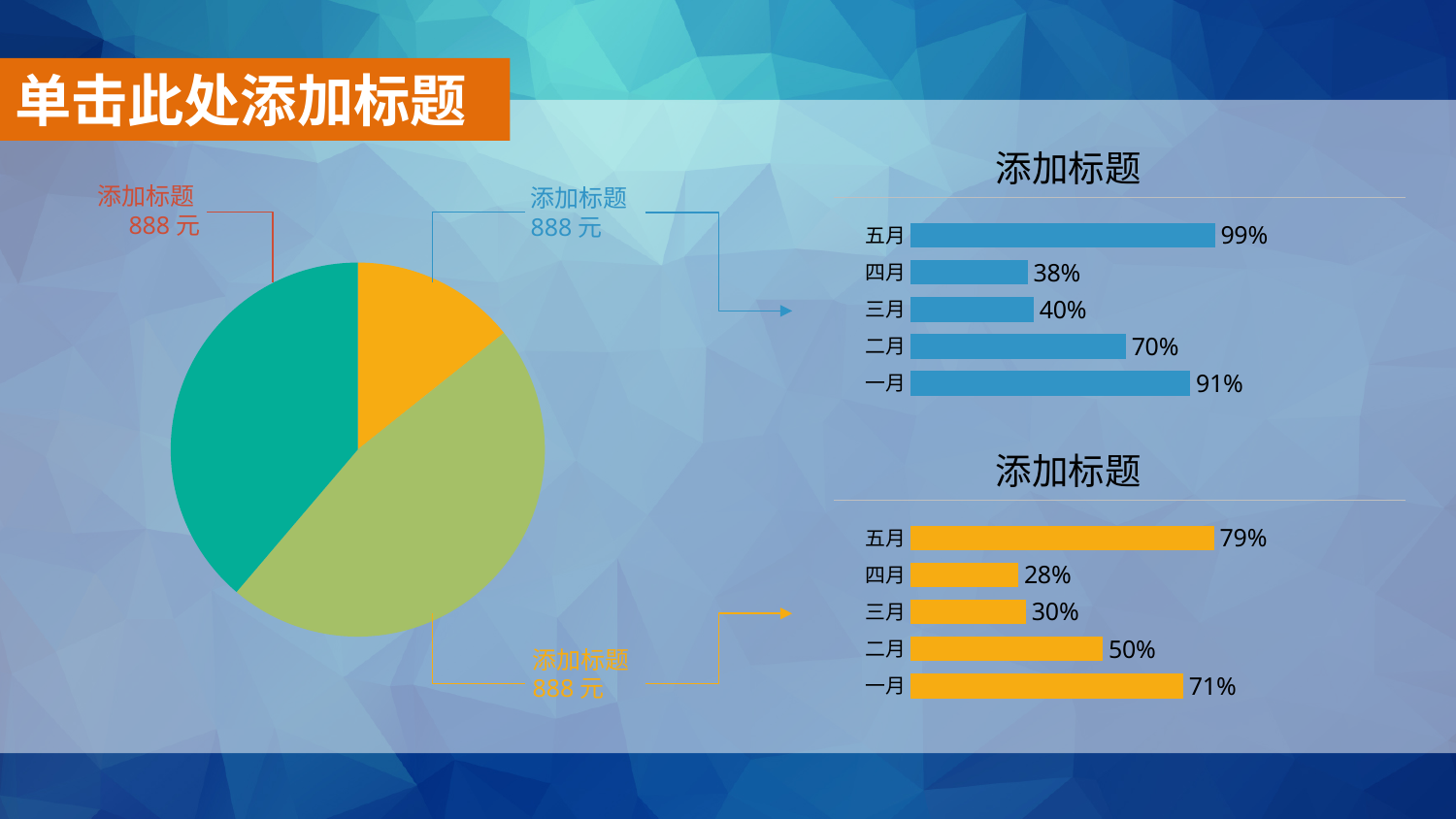
In the upper-right bar chart, what is the difference between the values for 五月 and 一月? 8% In the lower-right bar chart, which month has the highest value? 五月 What kind of chart is shown on the left side of the slide? Pie chart In the lower-right bar chart, what is the value for 三月? 30% How many months are shown in the upper-right bar chart? 5 In the lower-right bar chart, which is larger, the value for 二月 or the value for 三月? 二月 In the upper-right bar chart, which month has the highest value? 五月 In the upper-right bar chart, which month has the lowest value? 四月 In the upper-right bar chart, what is the value for 二月? 70% In the lower-right bar chart, what is the difference between the values for 一月 and 二月? 21% How many slices does the pie chart on the left have? 3 In the lower-right bar chart, which month has the lowest value? 四月